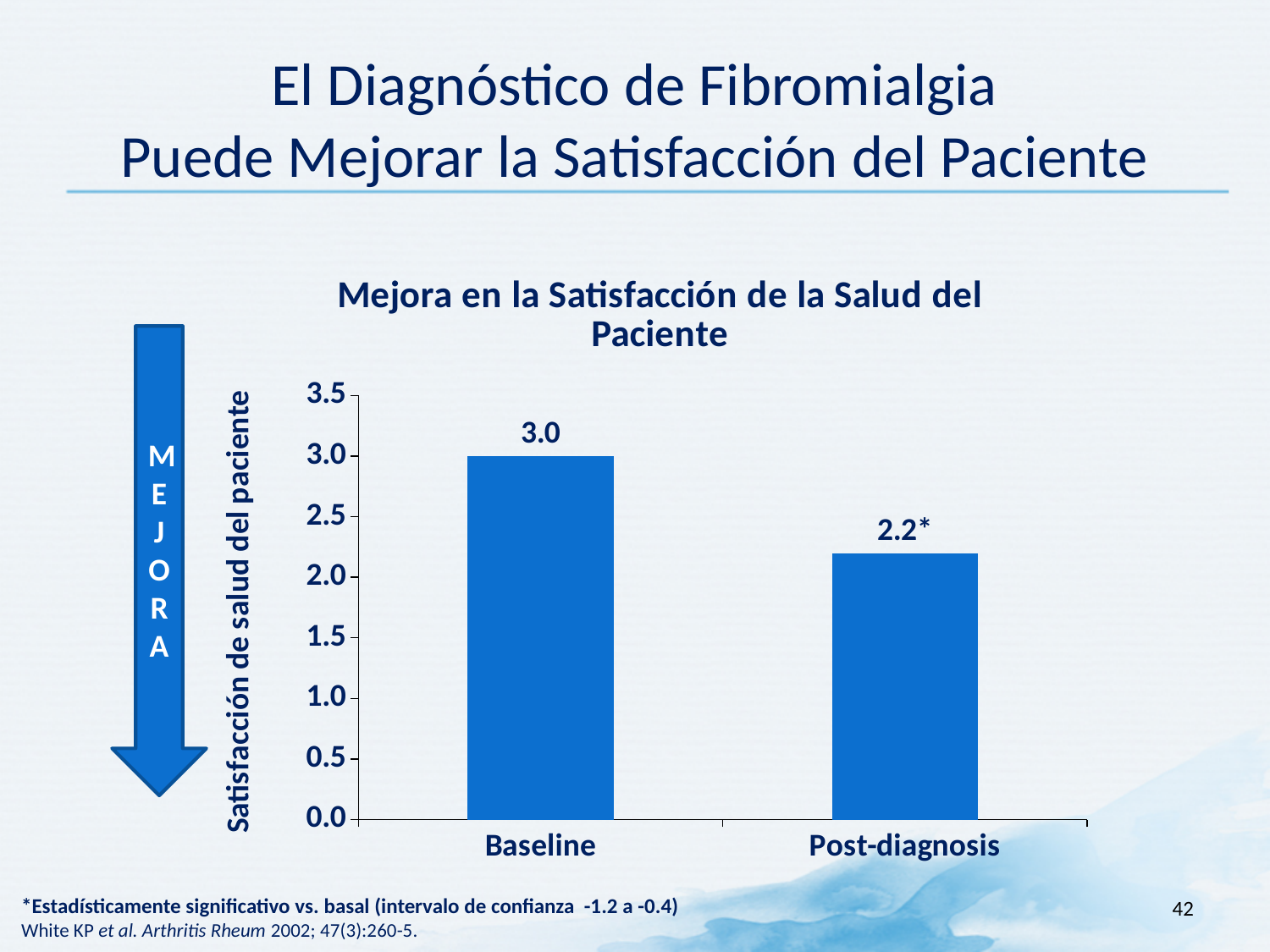
Is the value for Post-diagnosis greater or less than 2.5? less What is the value for Baseline? 3.0 Do the values rise or fall from Baseline to Post-diagnosis? fall Which is larger, the value for Baseline or the value for Post-diagnosis? Baseline What is the value for Post-diagnosis? 2.2 What kind of chart is shown on the slide? bar chart What is the difference between the Baseline and Post-diagnosis values? 0.8 Which category has the lowest value? Post-diagnosis What is the label of the y axis? Satisfacción de salud del paciente Which category has the highest value? Baseline How many categories are shown on the x axis? 2 What is the title of the chart? Mejora en la Satisfacción de la Salud del Paciente